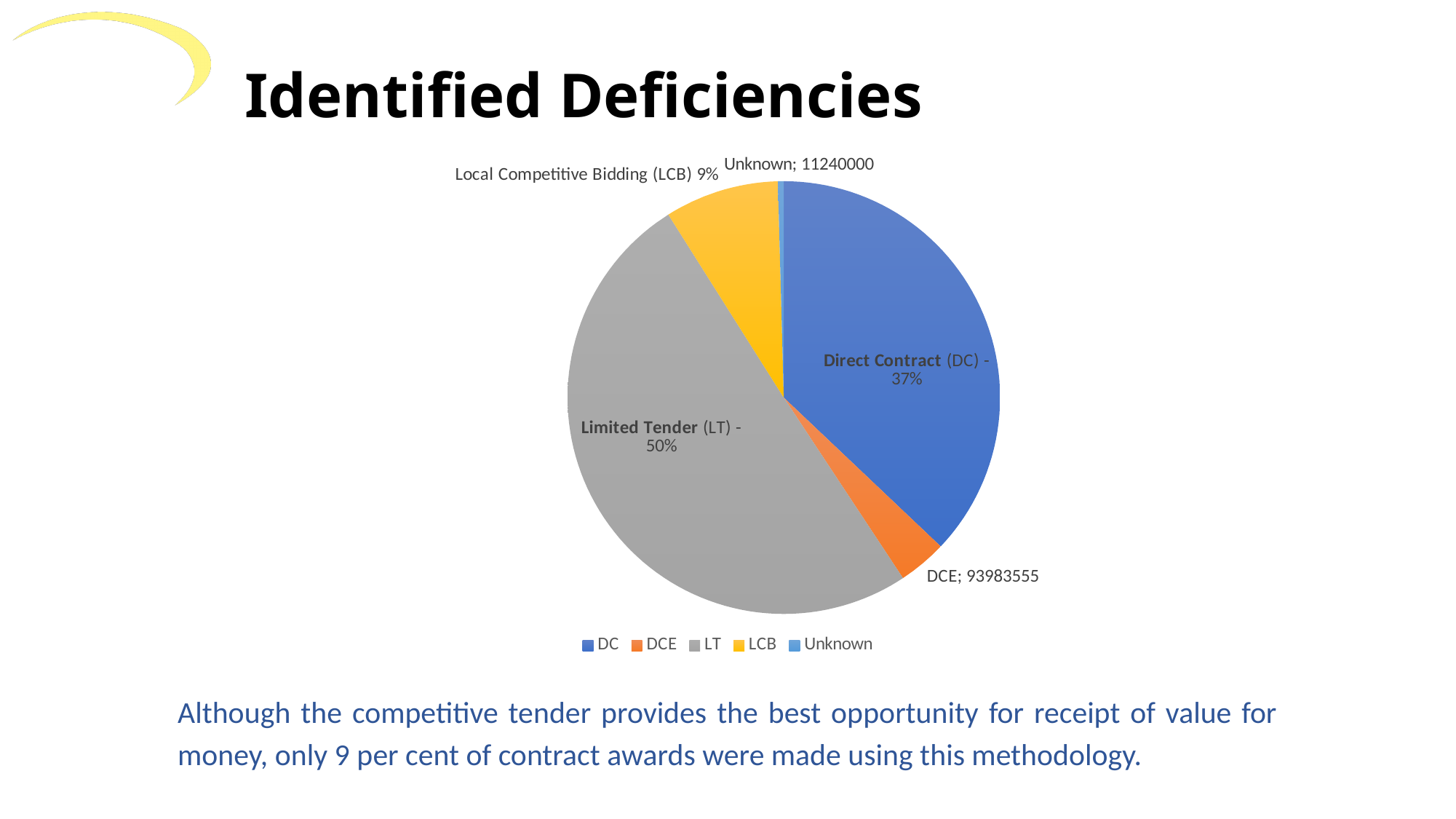
What kind of chart is shown on the slide? pie chart What percentage is shown for Local Competitive Bidding (LCB)? 9% What percentage is shown for Limited Tender (LT)? 50% Which category has the smallest slice of the pie? Unknown Which is larger, the slice for DC or the slice for LT? LT What value is labelled for DCE? 93983555 By how many percentage points does Limited Tender (LT) exceed Direct Contract (DC)? 13 What value is labelled for Unknown? 11240000 How many slices does the pie chart have? 5 Which category has the largest slice of the pie? Limited Tender (LT) How many entries does the legend list? 5 What percentage is shown for Direct Contract (DC)? 37%